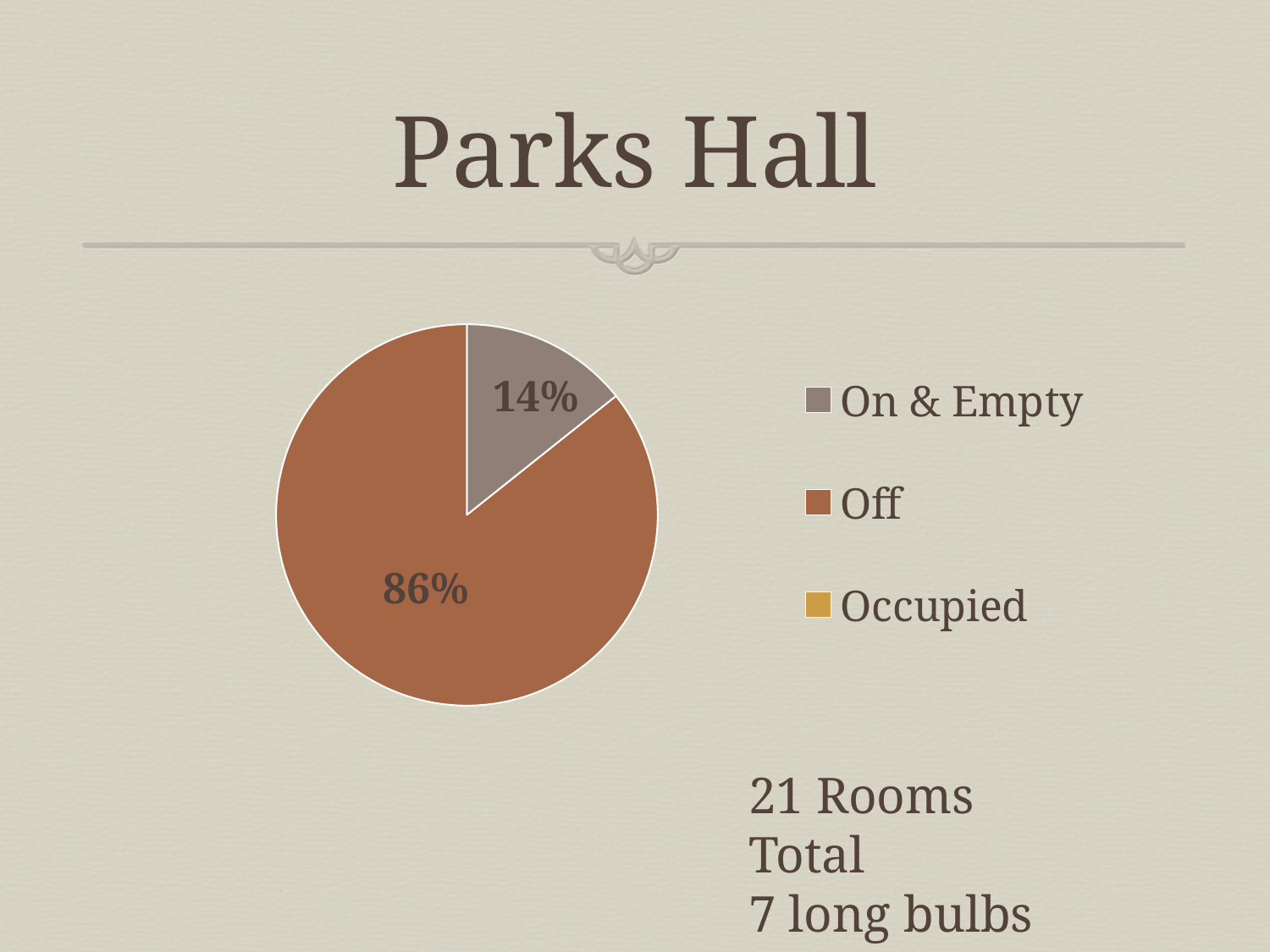
What colour is the Off slice in the pie chart? brown Is the share for Off larger or smaller than the share for On & Empty? larger Which legend category has no visible slice in the pie? Occupied What kind of chart is shown on the slide? pie chart Is the share for On & Empty greater or less than 50%? less What is the difference in percentage points between the Off slice and the On & Empty slice? 72% Which category has the largest slice of the pie? Off What share of the pie does the Off slice represent? 86% What share of the pie does the On & Empty slice represent? 14% Which of the two visible slices is smaller, On & Empty or Off? On & Empty How many categories does the legend list? 3